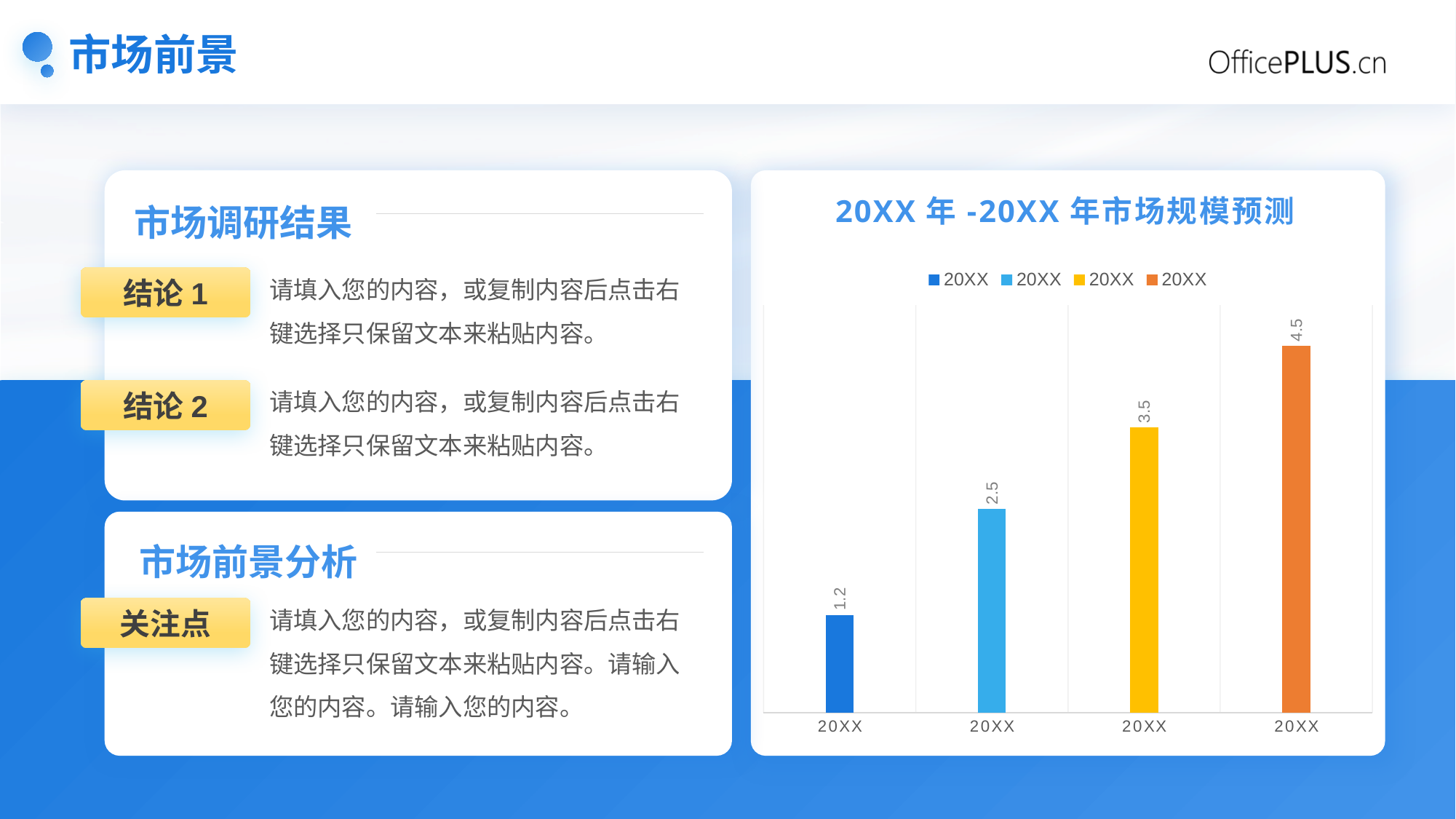
How many entries does the chart legend list? 4 What is the value of the second (light blue) bar? 2.5 Do the bar values rise or fall from left to right along the x axis? rise What is the title of the chart? 20XX 年 -20XX 年市场规模预测 What is the difference between the fourth bar (4.5) and the first bar (1.2)? 3.3 What type of chart is shown on the slide? bar chart What is the value of the fourth (rightmost, orange) bar? 4.5 How many bars are plotted in the chart? 4 What is the value of the first (leftmost, dark blue) bar? 1.2 What is the value of the third (yellow) bar? 3.5 Which bar has the lowest value? the first (dark blue) bar, 1.2 Which bar has the highest value? the fourth (orange) bar, 4.5